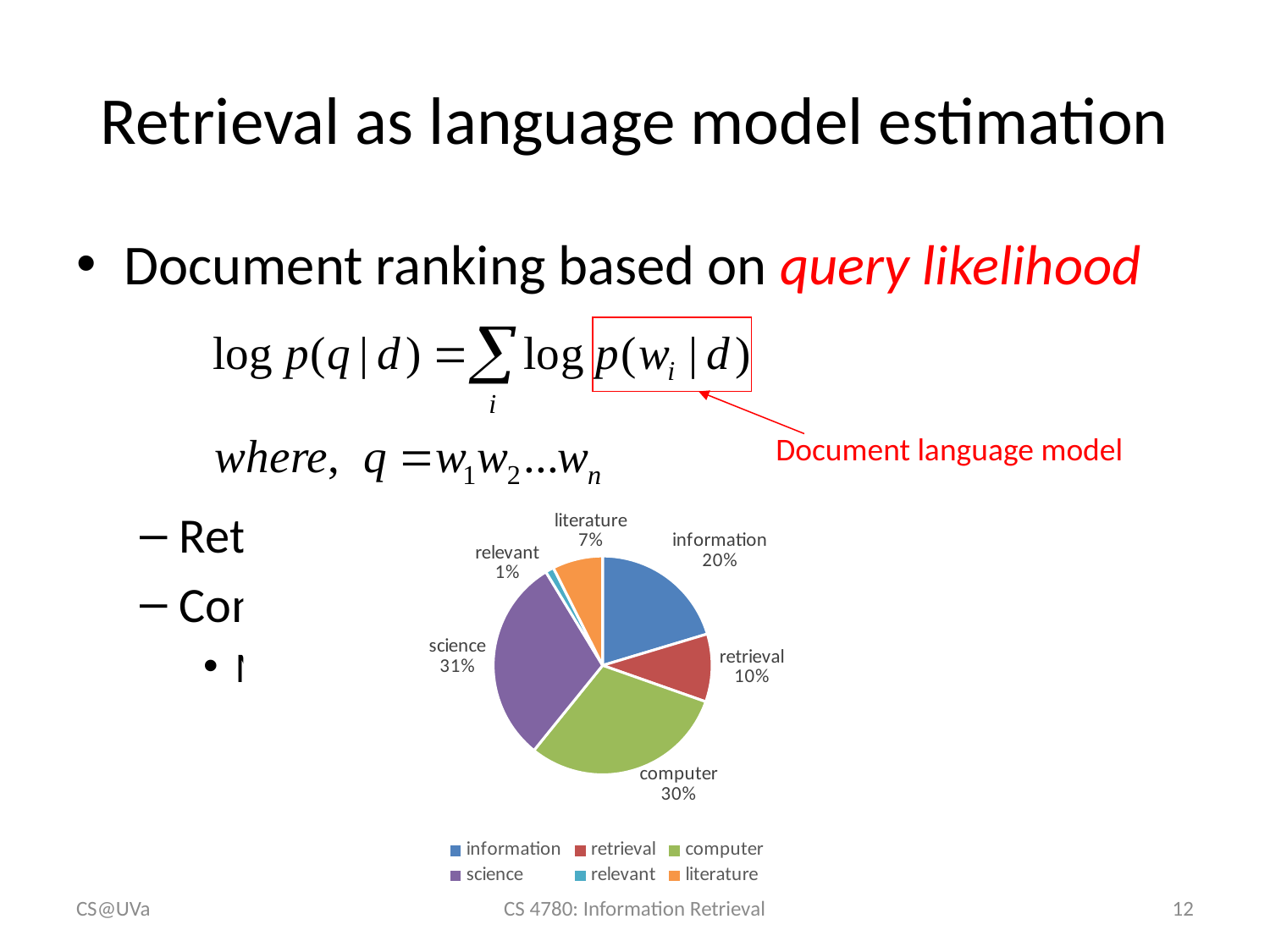
What share of the pie does "information" have? 20% Which slice of the pie is the smallest? relevant How many slices does the pie chart have? 6 What share of the pie does "retrieval" have? 10% How many entries does the legend list? 6 What kind of chart is shown on the slide? pie chart What share of the pie does "computer" have? 30% What colour is the "computer" slice in the pie chart? green What share of the pie does "literature" have? 7% What is the difference between the shares of "science" and "retrieval"? 21% Which has a larger share, "information" or "literature"? information Which slice of the pie is the largest? science